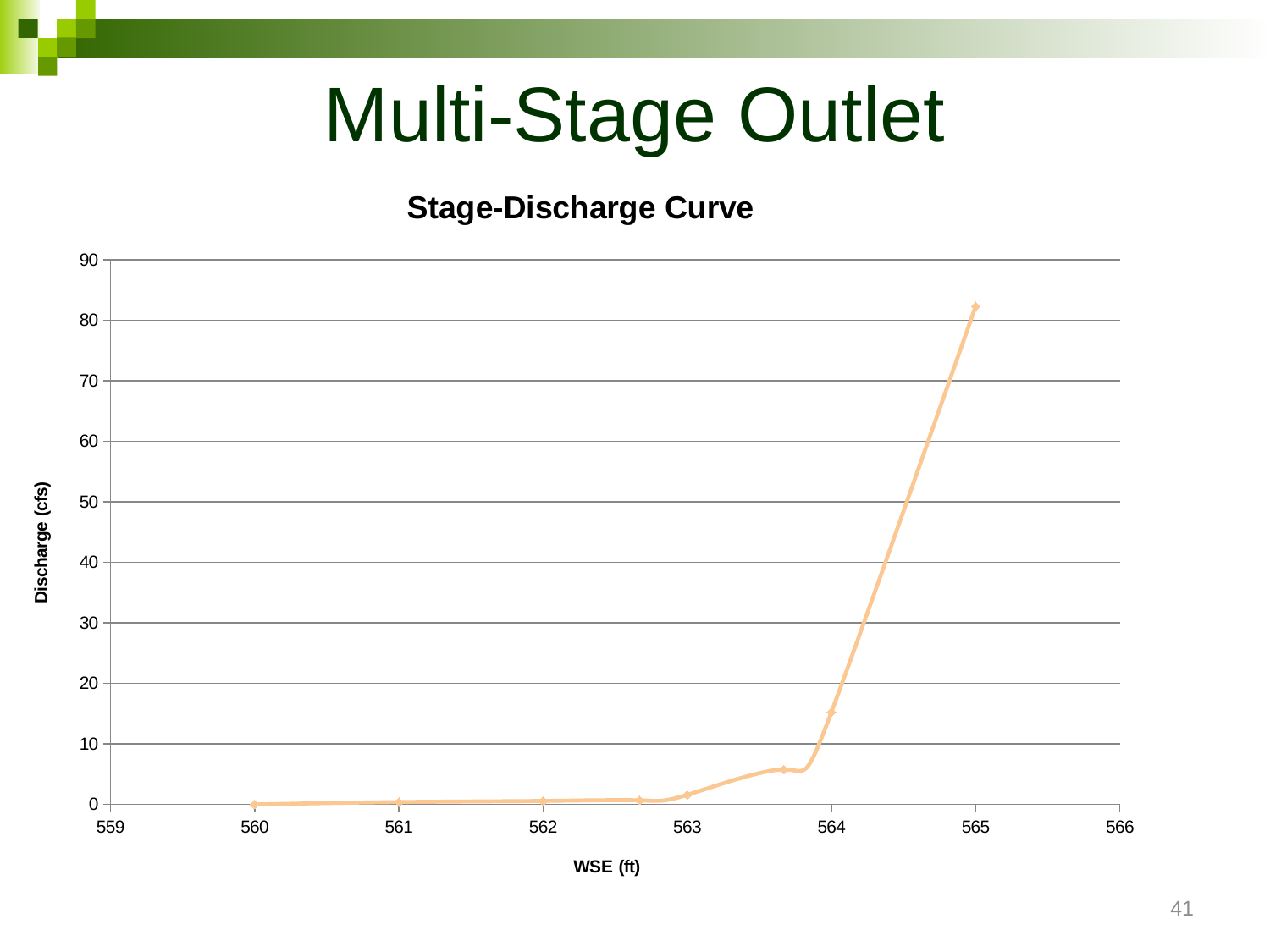
Is the discharge at WSE 565 ft greater or less than 70 cfs? greater Which has the larger discharge, WSE 561 ft or WSE 564 ft? 564 What is the title of the chart? Stage-Discharge Curve Is the discharge at WSE 564 ft greater or less than 10 cfs? greater Which has the larger discharge, WSE 564 ft or WSE 565 ft? 565 What kind of chart is shown on the slide? line chart What is the highest value shown on the vertical axis? 90 Is the discharge at WSE 564 ft greater or less than 20 cfs? less At which WSE value is the discharge highest? 565 What is the label of the vertical axis? Discharge (cfs) Does the discharge rise or fall as WSE increases from 560 to 565 ft? rise